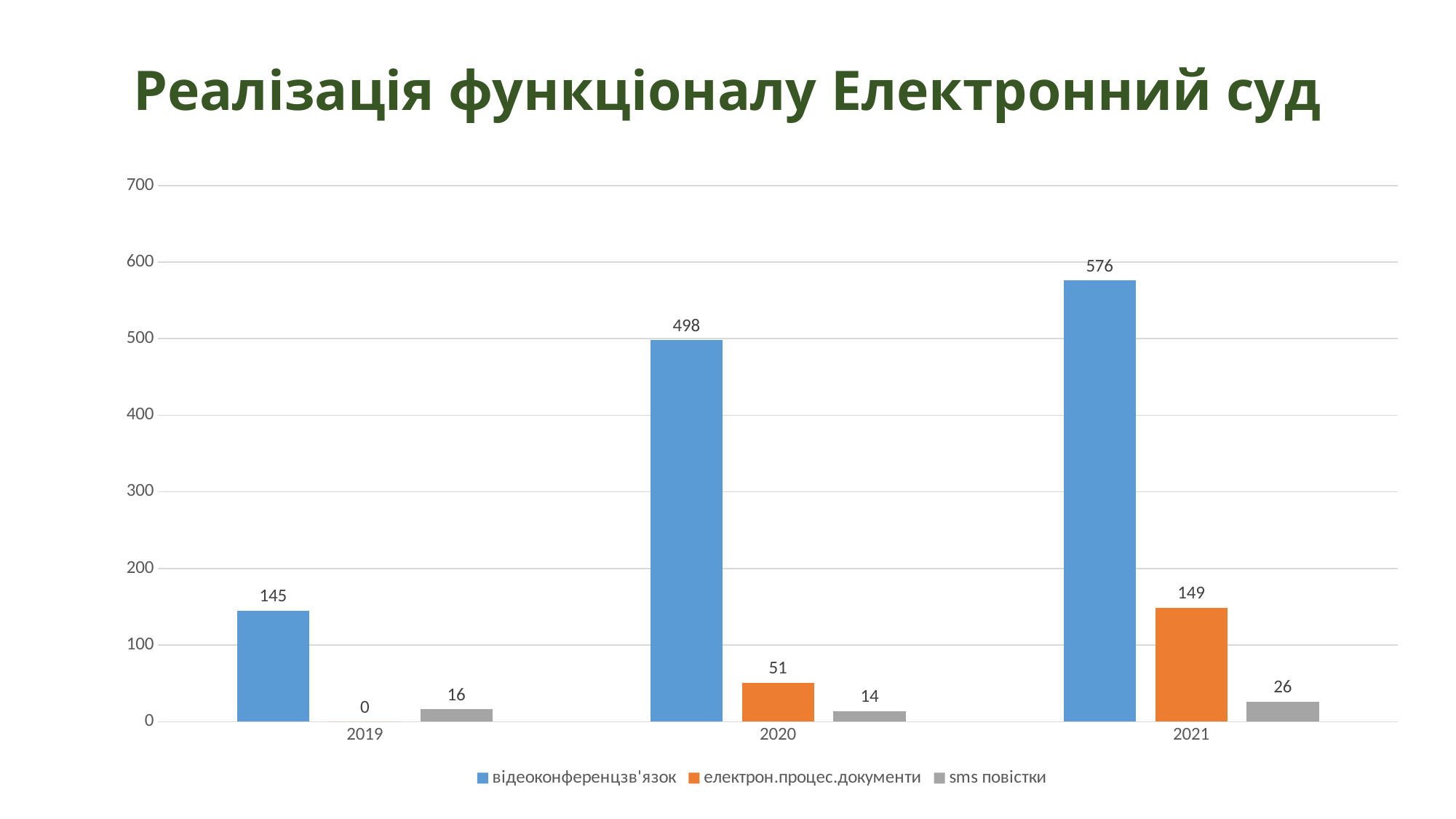
What is the value for sms повістки in 2019? 16 What kind of chart is shown on the slide? bar chart In which year is the value for відеоконференцзв'язок highest? 2021 What is the value for відеоконференцзв'язок in 2020? 498 What is the difference between the відеоконференцзв'язок values for 2021 and 2020? 78 How many series does the legend list? 3 How many years are shown on the x axis? 3 Which is larger: електрон.процес.документи in 2020 or sms повістки in 2021? електрон.процес.документи in 2020 Does the value for електрон.процес.документи rise or fall from 2019 to 2021? rise In which year is the value for sms повістки lowest? 2020 Is the value for відеоконференцзв'язок in 2019 greater or less than 200? less What is the value for електрон.процес.документи in 2021? 149